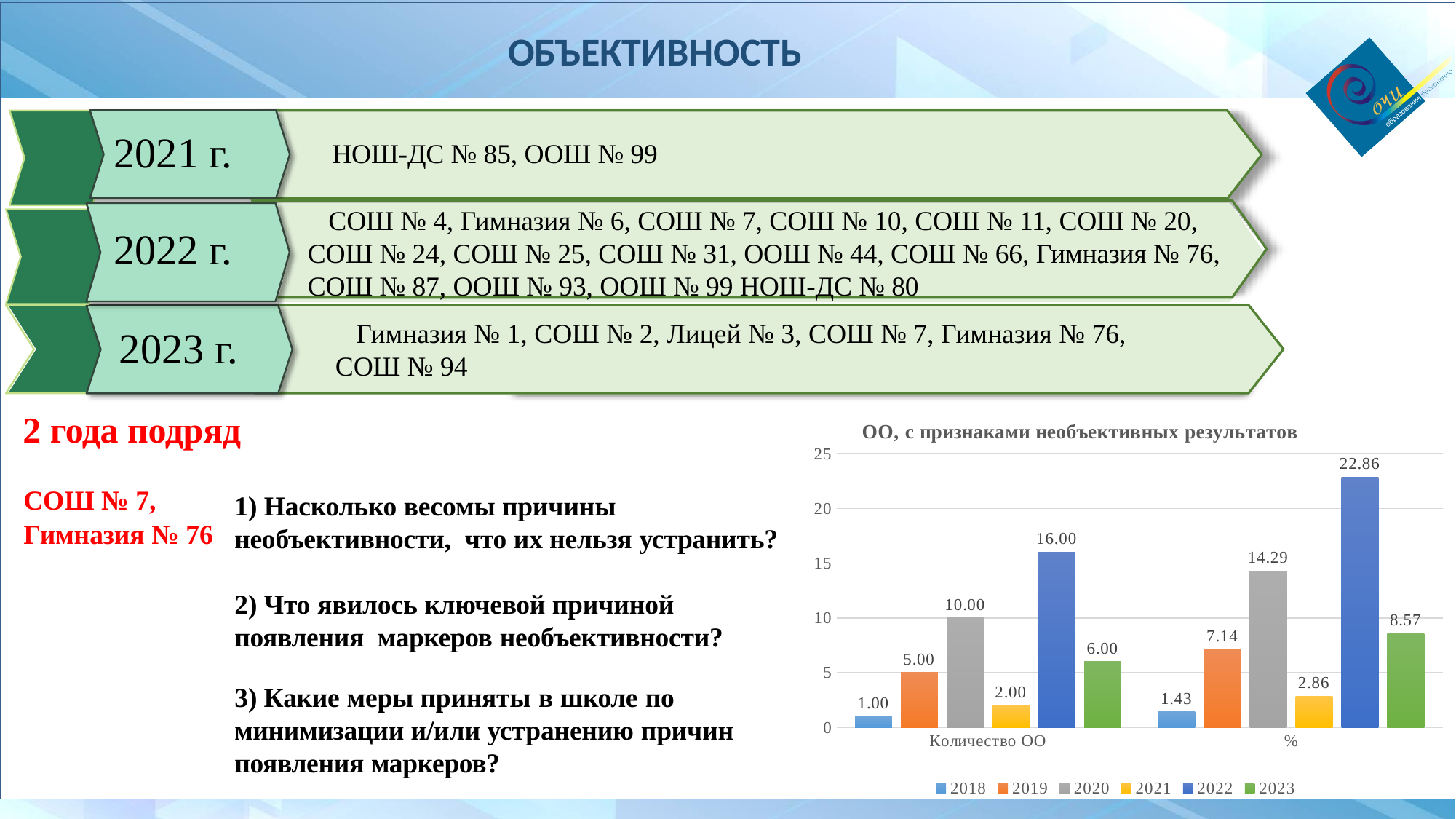
Which year has the highest value in the '%' category? 2022 What is the value for 2022 in the 'Количество ОО' category? 16.00 How many categories are shown on the x axis of the chart? 2 What is the value for 2018 in the 'Количество ОО' category? 1.00 What type of chart is shown on the slide? bar chart What is the value for 2020 in the '%' category? 14.29 What is the difference between the 2022 and 2023 values in the 'Количество ОО' category? 10.00 How many series does the chart legend list? 6 Which is larger in the '%' category: the value for 2019 or the value for 2023? 2023 Which year has the lowest value in the 'Количество ОО' category? 2018 What is the title of the chart on the slide? ОО, с признаками необъективных результатов Is the value for 2022 in the '%' category greater or less than 20? greater